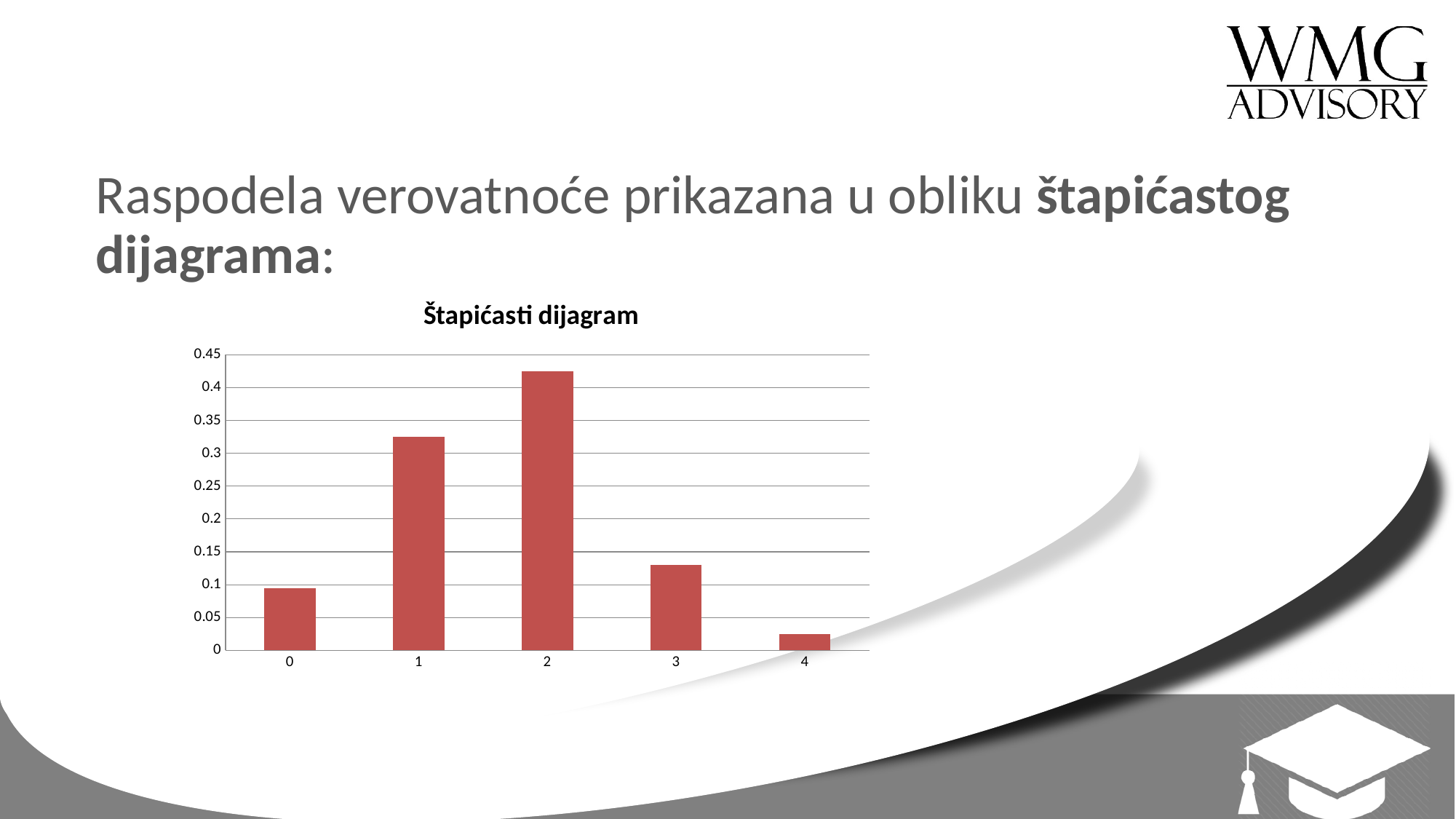
Is the value for category 4 greater or less than 0.05? less Which category has the highest bar in the chart? 2 Is the value for category 1 greater or less than 0.3? greater What kind of chart is shown on the slide? bar chart Is the value for category 3 greater or less than 0.15? less How many categories are shown on the x axis of the chart? 5 What is the title of the chart? Štapićasti dijagram What colour are the bars in the chart? red Which category has the lowest bar in the chart? 4 Which is larger, the value for category 1 or the value for category 3? 1